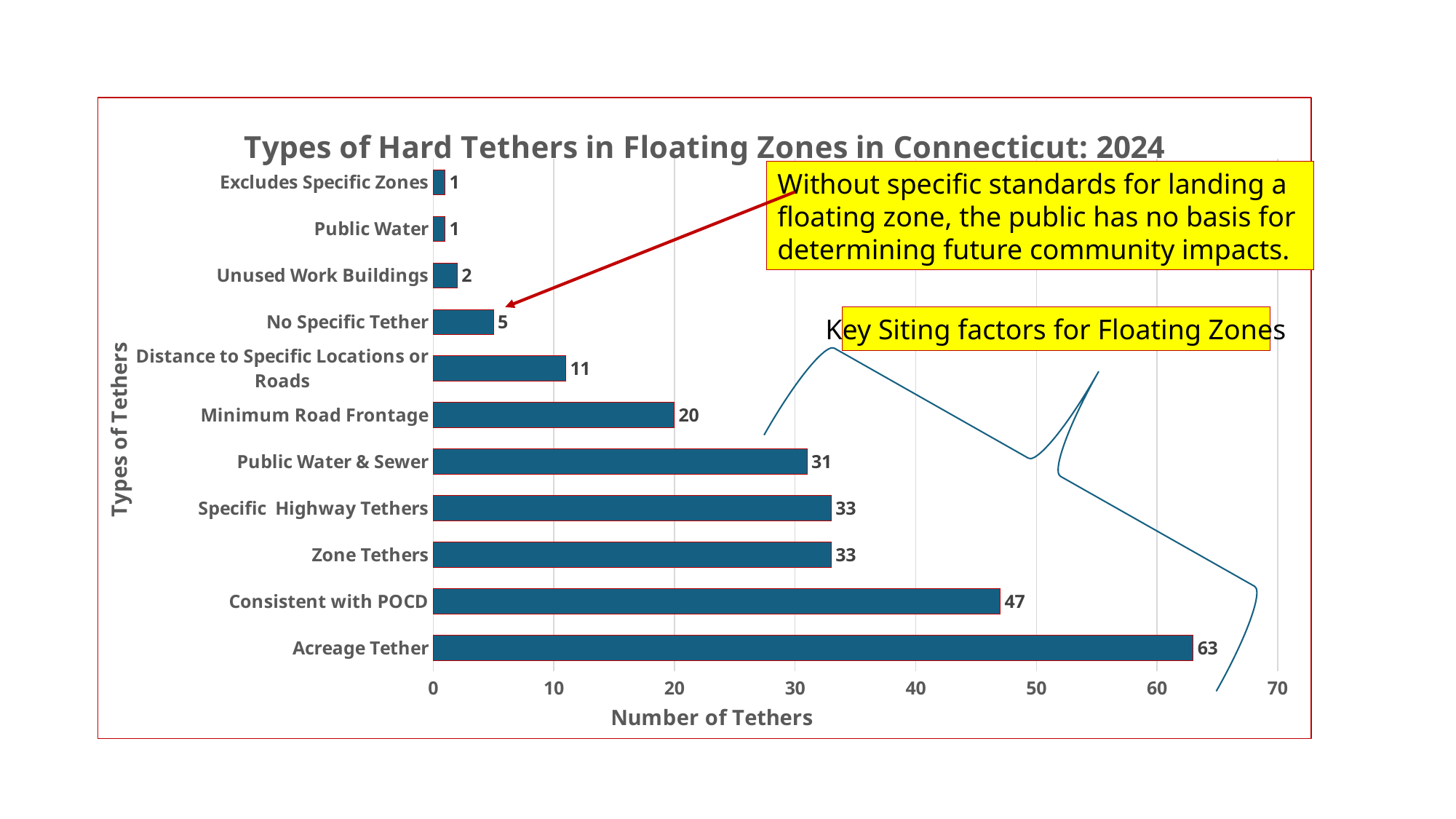
Is the value for Consistent with POCD greater or less than 40? greater What kind of chart is shown on the slide? Bar chart How many categories are shown on the chart? 11 Which category has the highest number of tethers? Acreage Tether Which is larger, the value for Distance to Specific Locations or Roads or the value for Unused Work Buildings? Distance to Specific Locations or Roads What is the value for Consistent with POCD? 47 What is the value for Acreage Tether? 63 What is the value for No Specific Tether? 5 What is the value for Minimum Road Frontage? 20 What is the difference between the values for Public Water & Sewer and Minimum Road Frontage? 11 What is the title of the chart? Types of Hard Tethers in Floating Zones in Connecticut: 2024 What is the difference between the values for Acreage Tether and Consistent with POCD? 16